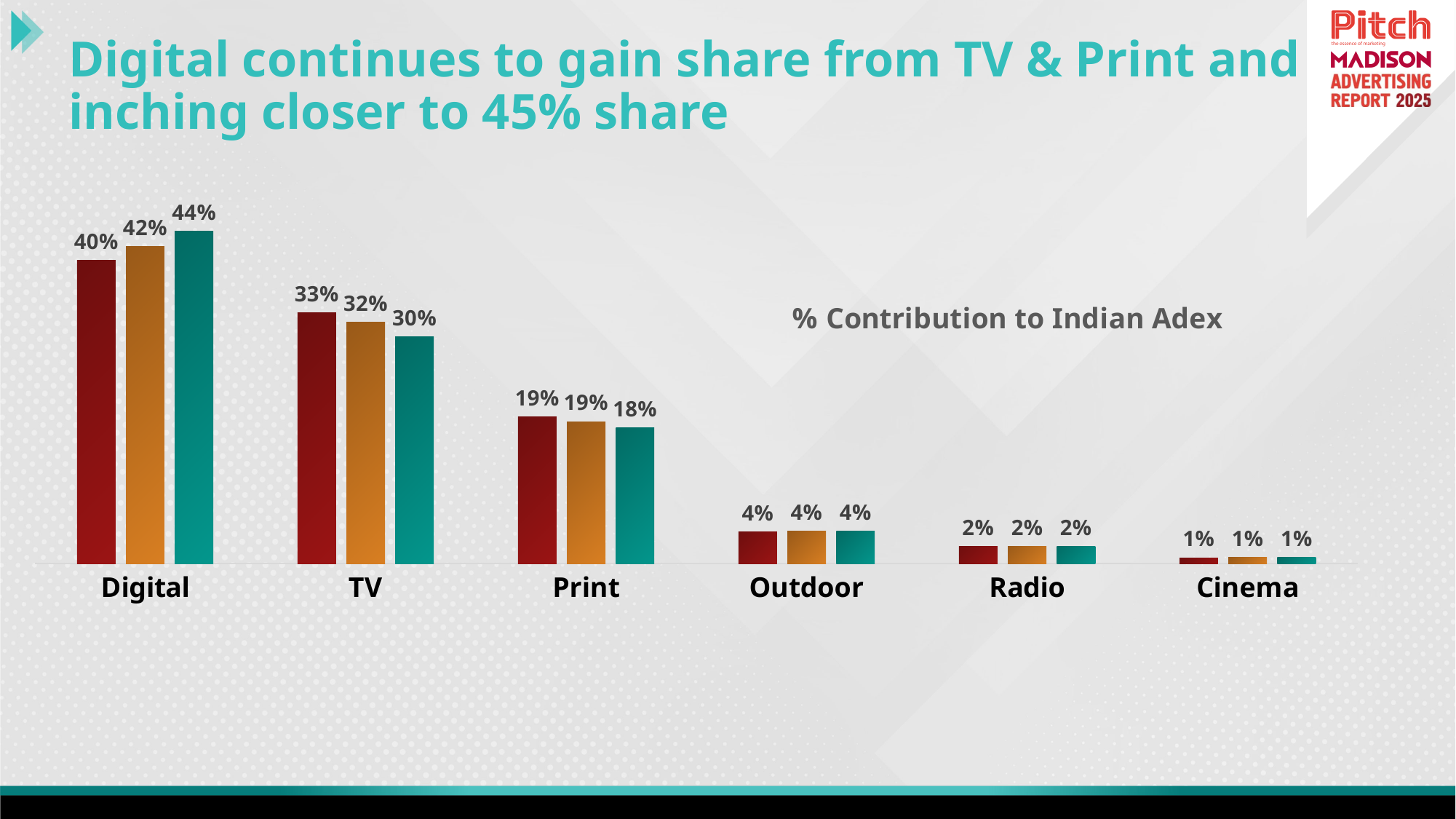
What kind of chart is shown on the slide? Bar chart What is the difference between the teal bar for Digital and the teal bar for TV? 14% Which category has the highest values in the chart? Digital Which is larger, the red bar for Digital or the red bar for TV? Digital What is the difference between the teal (third) bar and the red (first) bar for Digital? 4% Which category has the lowest values in the chart? Cinema How many bars are shown for each category? 3 What is the value of the orange (middle) bar for Print? 19% What is the value of the teal (third) bar for Digital? 44% How many categories are shown on the x axis? 6 What is the value of the red (first) bar for TV? 33% What value is shown for each of the three bars for Outdoor? 4%